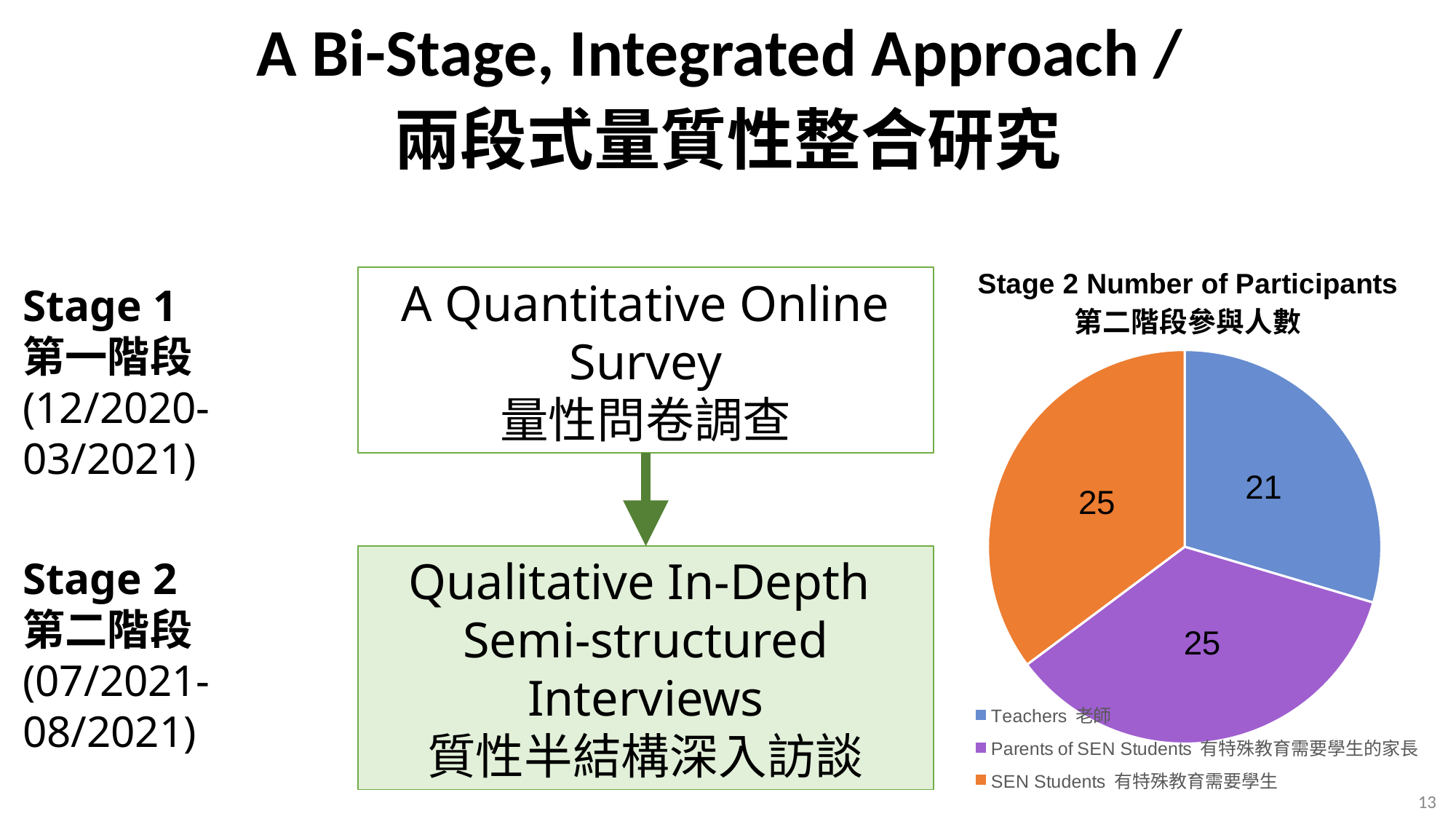
What is the number of Teachers in the Stage 2 Number of Participants pie chart? 21 How many entries does the legend of the Stage 2 Number of Participants chart list? 3 Which participant group has the smallest slice in the Stage 2 Number of Participants pie chart? Teachers How many participant groups are shown in the Stage 2 Number of Participants pie chart? 3 What is the total number of Stage 2 participants across all three groups in the pie chart? 71 Which group is larger in the Stage 2 pie chart, Teachers or SEN Students? SEN Students What is the English title of the pie chart on the slide? Stage 2 Number of Participants How many Parents of SEN Students participated in Stage 2 according to the pie chart? 25 What is the difference between the number of Parents of SEN Students and the number of Teachers in the pie chart? 4 What is the number of SEN Students shown in the Stage 2 Number of Participants pie chart? 25 What type of chart is used to show the Stage 2 Number of Participants? Pie chart What colour represents Teachers in the Stage 2 Number of Participants pie chart? Blue